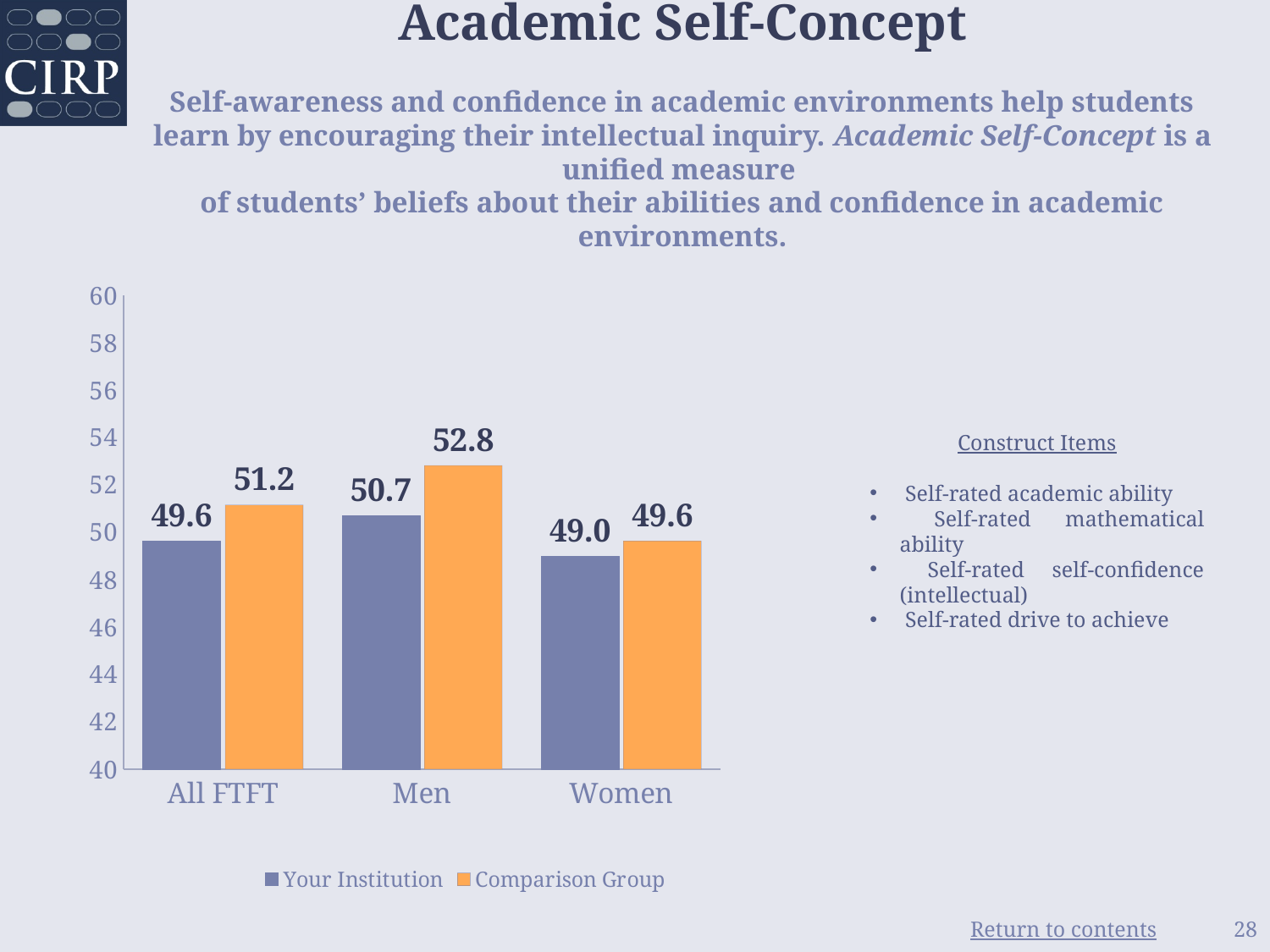
What is the value for Your Institution in the All FTFT category? 49.6 Which is larger for All FTFT: Your Institution or Comparison Group? Comparison Group How many series does the legend list? 2 What is the value for the Comparison Group in the Women category? 49.6 What kind of chart is shown on the slide? bar chart What is the value for Your Institution in the Men category? 50.7 What is the difference between the Comparison Group and Your Institution values for Men? 2.1 What colour are the Comparison Group bars? orange Which category has the lowest Your Institution value? Women How many categories are shown on the x axis? 3 Which category has the highest Comparison Group value? Men Is the Comparison Group value for Men greater or less than 52? greater